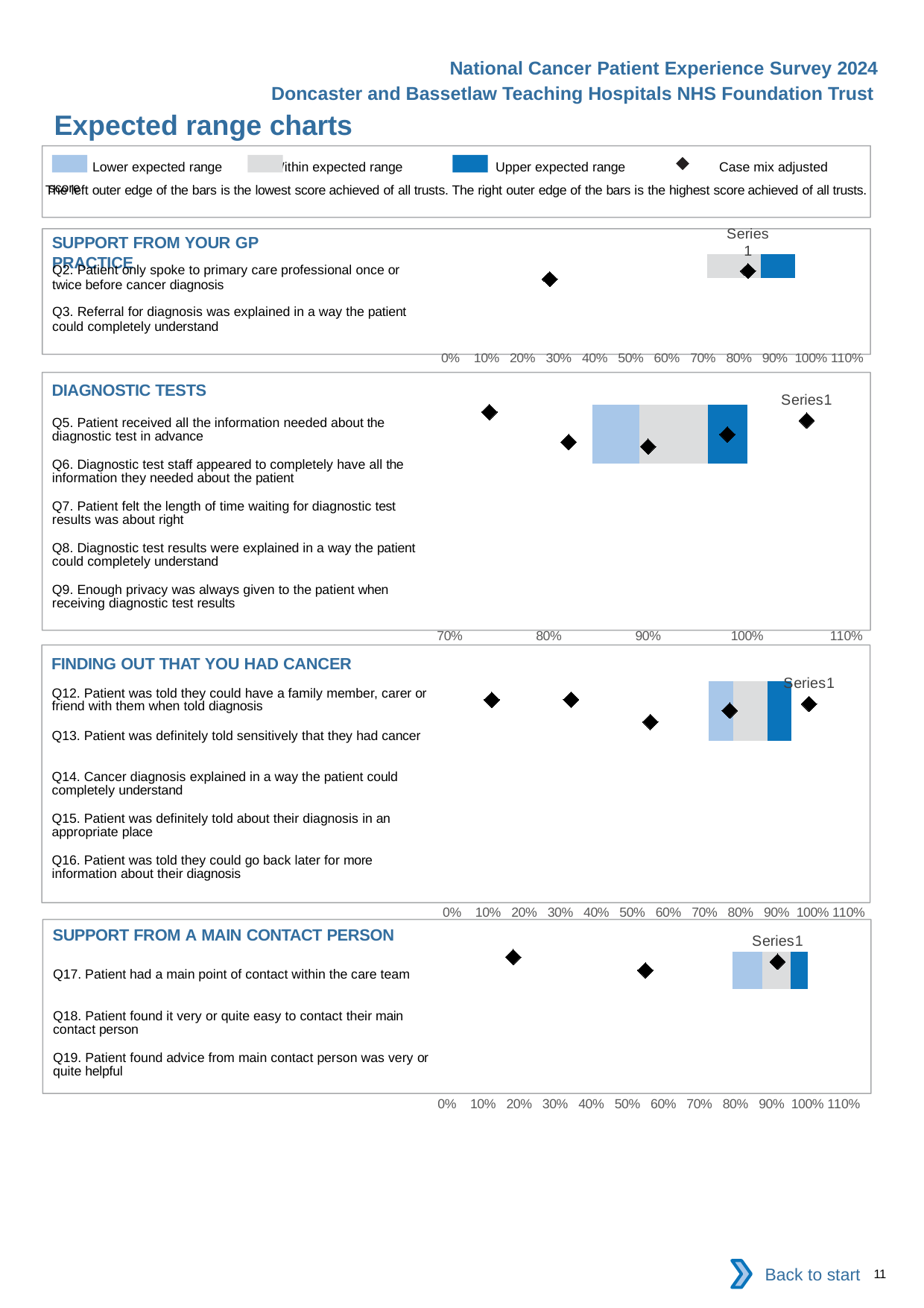
What kind of chart is used in the 'DIAGNOSTIC TESTS' section? Bar chart In the 'DIAGNOSTIC TESTS' chart, how many case mix adjusted score markers (diamonds) are plotted? 5 How many charts are shown on the slide? 4 In the 'DIAGNOSTIC TESTS' chart, what is the lowest value shown on the x axis? 70% In the 'DIAGNOSTIC TESTS' chart, how many questions are listed? 5 According to the legend, which colour represents the upper expected range? Dark blue How many entries does the legend at the top of the slide list? 4 In the 'DIAGNOSTIC TESTS' chart, is the leftmost case mix adjusted score marker greater or less than 80%? less In the 'SUPPORT FROM A MAIN CONTACT PERSON' chart, is the leftmost case mix adjusted score marker greater or less than 30%? less